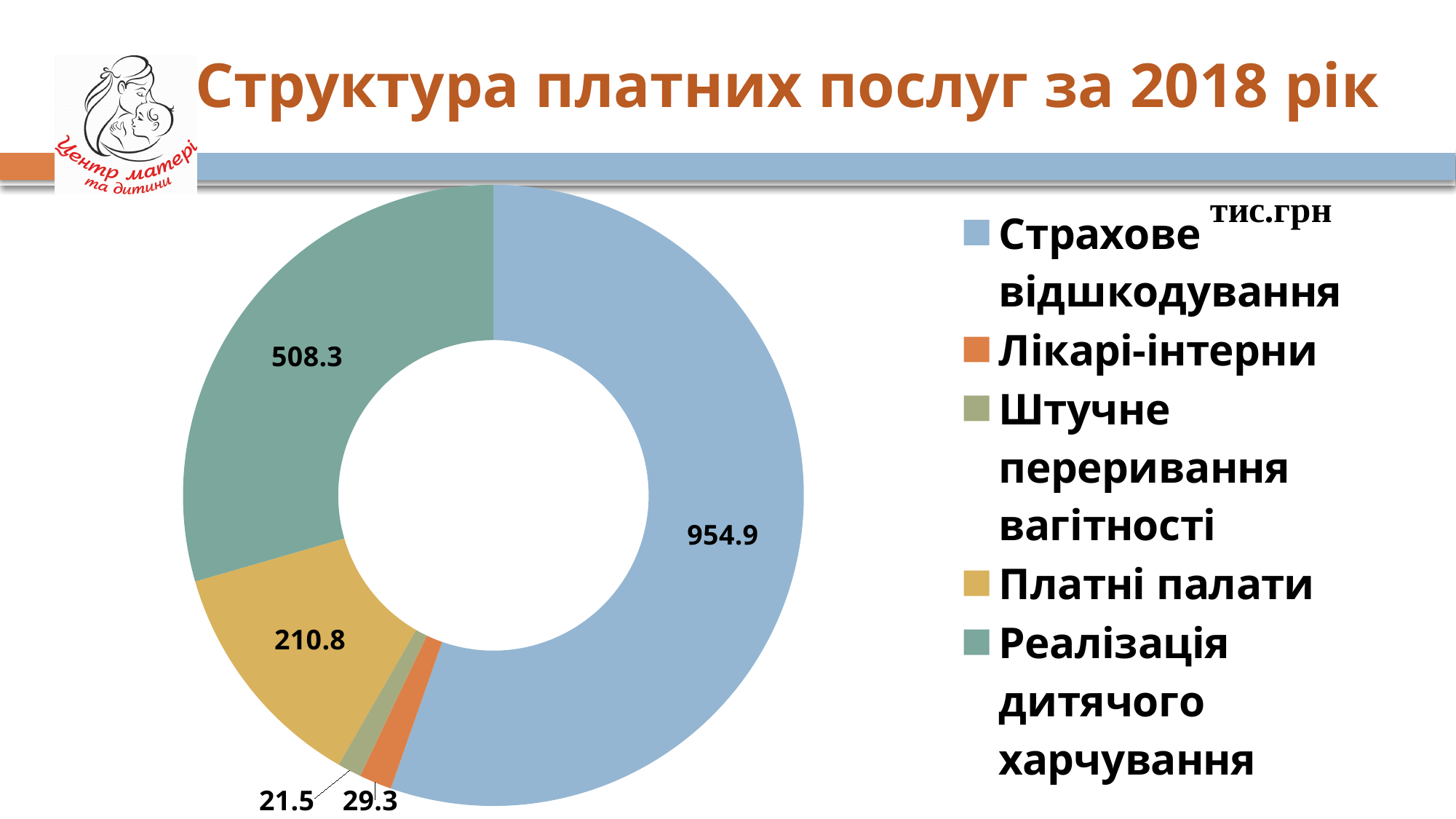
Which category has the largest value? Страхове відшкодування What is the value for Лікарі-інтерни? 29.3 What kind of chart is shown on the slide? doughnut (pie) chart Which is larger, Платні палати or Реалізація дитячого харчування? Реалізація дитячого харчування What is the difference between Страхове відшкодування and Реалізація дитячого харчування? 446.6 What is the value for Реалізація дитячого харчування? 508.3 What is the value for Платні палати? 210.8 How many categories does the chart show? 5 Which category has the smallest value? Штучне переривання вагітності What is the value for Штучне переривання вагітності? 21.5 What is the difference between Лікарі-інтерни and Штучне переривання вагітності? 7.8 What is the value for Страхове відшкодування? 954.9